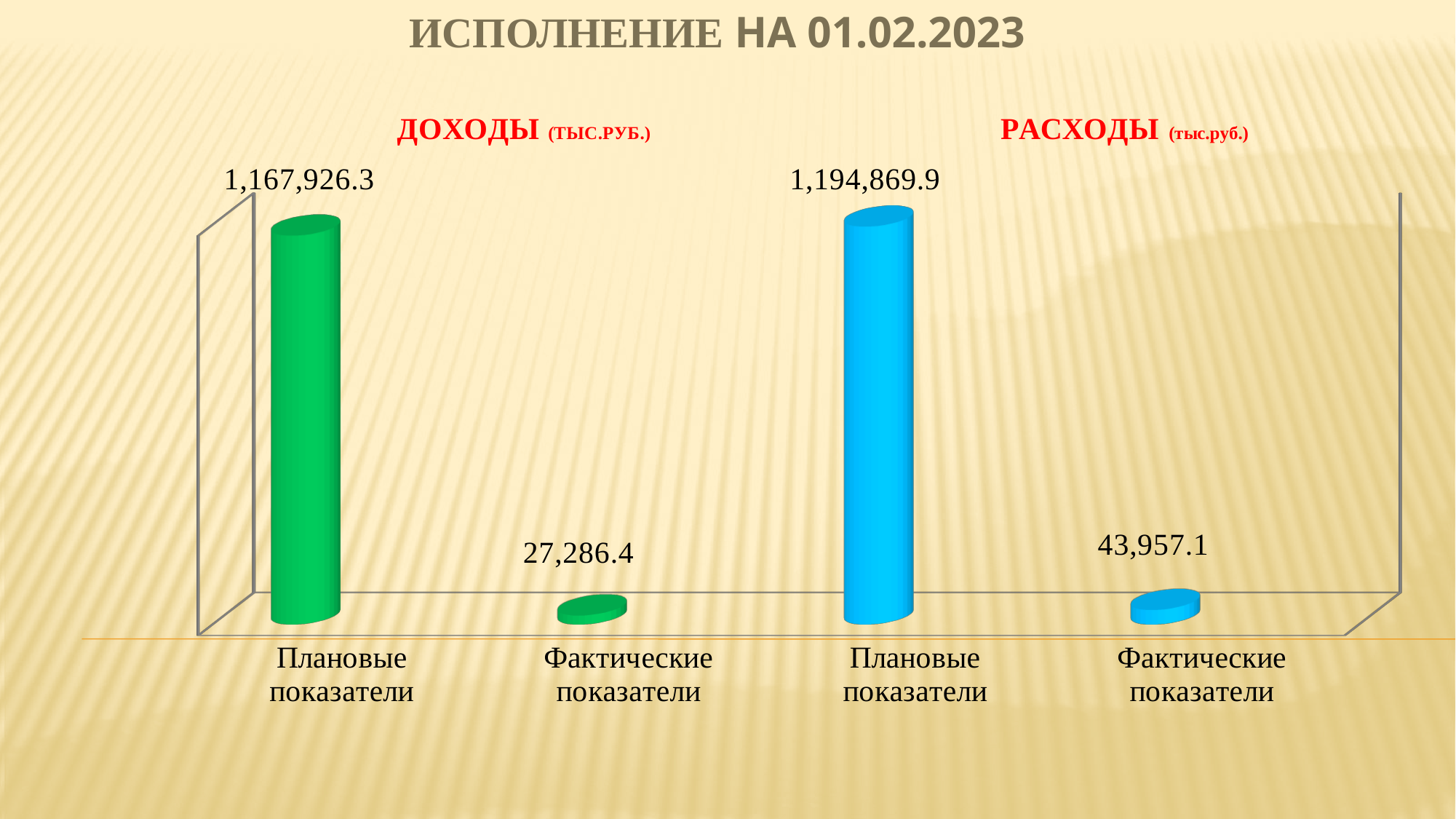
What type of chart is shown on the slide? Bar chart What is the difference between the planned and actual indicators under РАСХОДЫ? 1,150,912.8 What is the value of the planned indicators (Плановые показатели) bar under РАСХОДЫ? 1,194,869.9 What is the value of the planned indicators (Плановые показатели) bar under ДОХОДЫ? 1,167,926.3 What is the value of the actual indicators (Фактические показатели) bar under ДОХОДЫ? 27,286.4 How many bars are plotted on the chart? 4 What is the value of the actual indicators (Фактические показатели) bar under РАСХОДЫ? 43,957.1 Which bar has the highest value on the chart? Плановые показатели (РАСХОДЫ) Which bar has the lowest value on the chart? Фактические показатели (ДОХОДЫ) What is the difference between the planned and actual indicators under ДОХОДЫ? 1,140,639.9 Which is larger: the actual indicators for ДОХОДЫ or the actual indicators for РАСХОДЫ? РАСХОДЫ What is the title of the slide? ИСПОЛНЕНИЕ НА 01.02.2023